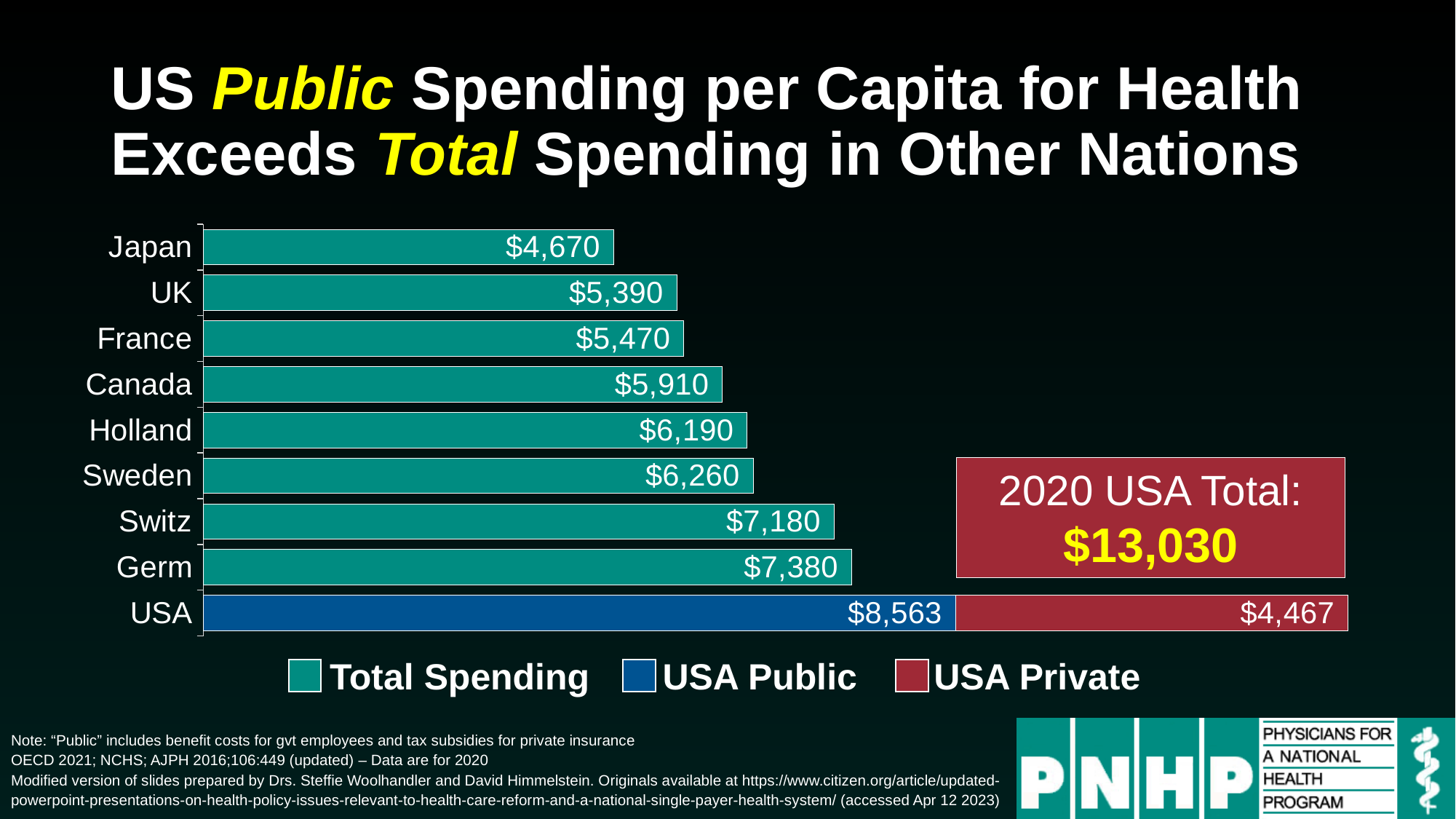
What is the USA Public spending per capita shown on the chart? $8,563 What colour represents USA Public spending in the legend? Blue What is the difference between Germany's total spending and Japan's total spending? $2,710 What kind of chart is shown on the slide? Bar chart How many countries are listed on the chart? 9 What is the total spending per capita for Japan? $4,670 What is the USA Private spending per capita shown on the chart? $4,467 Which is larger, Canada's total spending or Holland's total spending? Holland How many series does the legend list? 3 Which non-US country has the highest total spending per capita? Germ Which country has the lowest total spending per capita among the non-US nations shown? Japan What is the 2020 USA total spending per capita shown in the callout box? $13,030